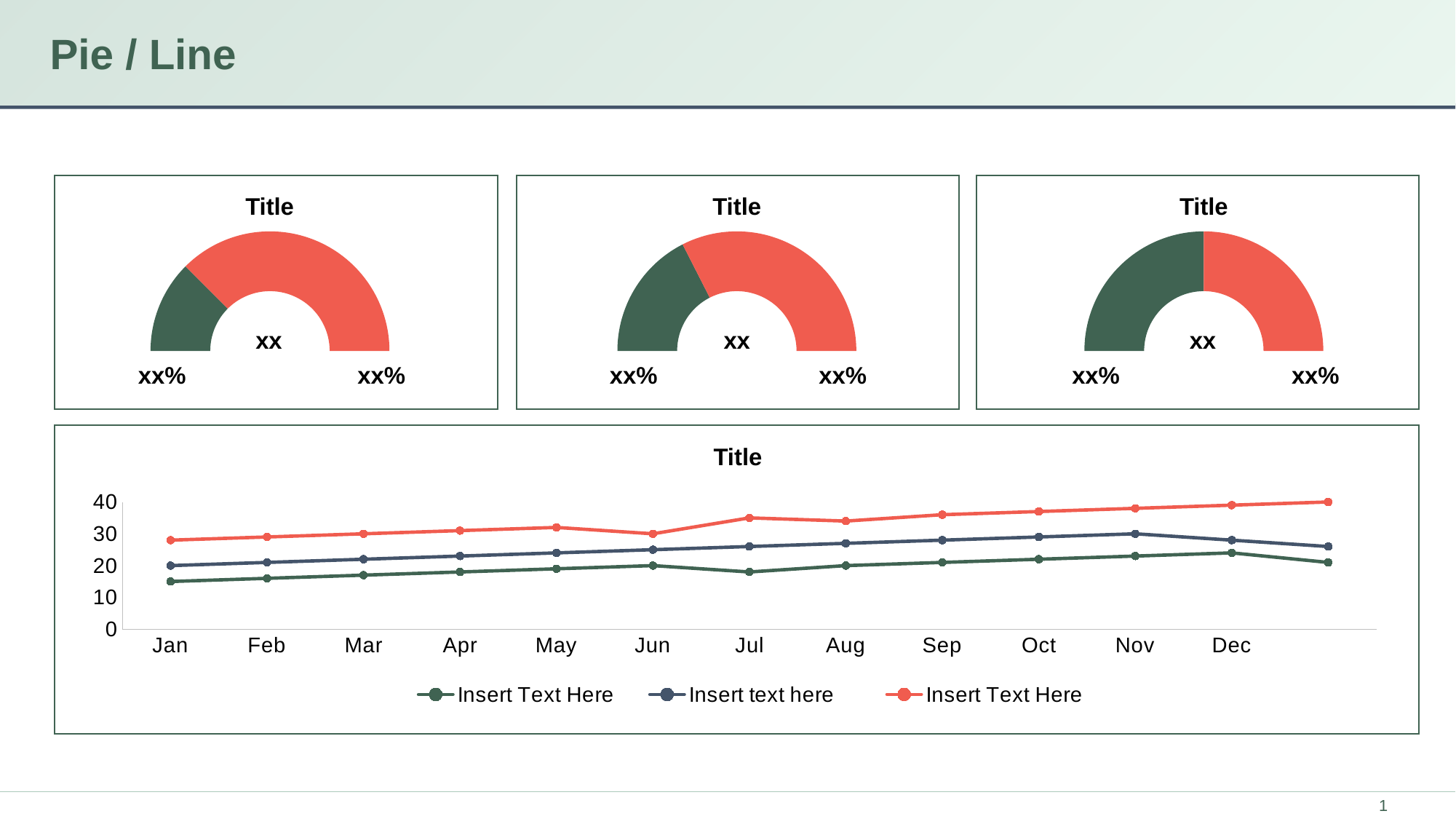
How many series does the legend of the bottom line chart list? 3 How many semicircle pie charts are shown in the top row of the slide? 3 In the bottom line chart, which month has the lowest value for the red series? Jan In the bottom line chart, is the value of the red series for Jan greater or less than 20? greater In the bottom line chart, which series has the larger value in Jan, the red series or the green series? the red series In the bottom line chart, which series has the larger value in Dec, the dark blue series or the green series? the dark blue series In the bottom line chart, does the red series generally rise or fall from Jan to Dec? rise In the bottom line chart, is the value of the green series for Jan greater or less than 20? less In the bottom line chart, is the value of the red series for Dec greater or less than 30? greater What kind of chart is the bottom chart on the slide? line chart How many month labels are shown on the x axis of the bottom line chart? 12